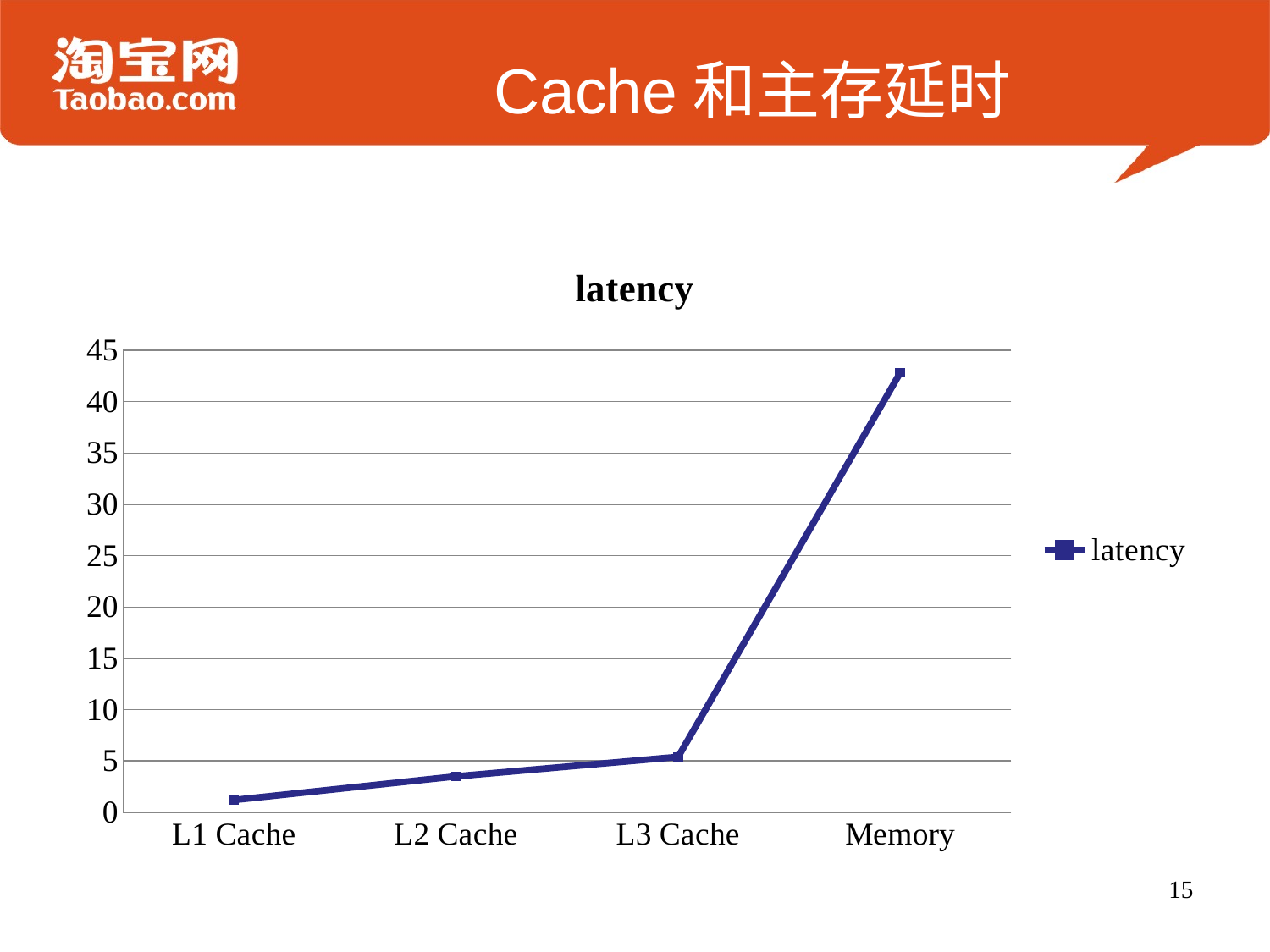
How many series does the legend list? 1 Is the latency for L3 Cache greater or less than 10? less How many categories are plotted along the x axis? 4 What kind of chart is shown on the slide? line chart Which has a larger latency, L3 Cache or Memory? Memory Is the latency for L1 Cache greater or less than 5? less Which has a larger latency, L1 Cache or L3 Cache? L3 Cache Which category has the highest latency? Memory Is the latency for Memory greater or less than 40? greater Which category has the lowest latency? L1 Cache Do the latency values rise or fall from L1 Cache to Memory along the x axis? rise What is the title of the chart? latency